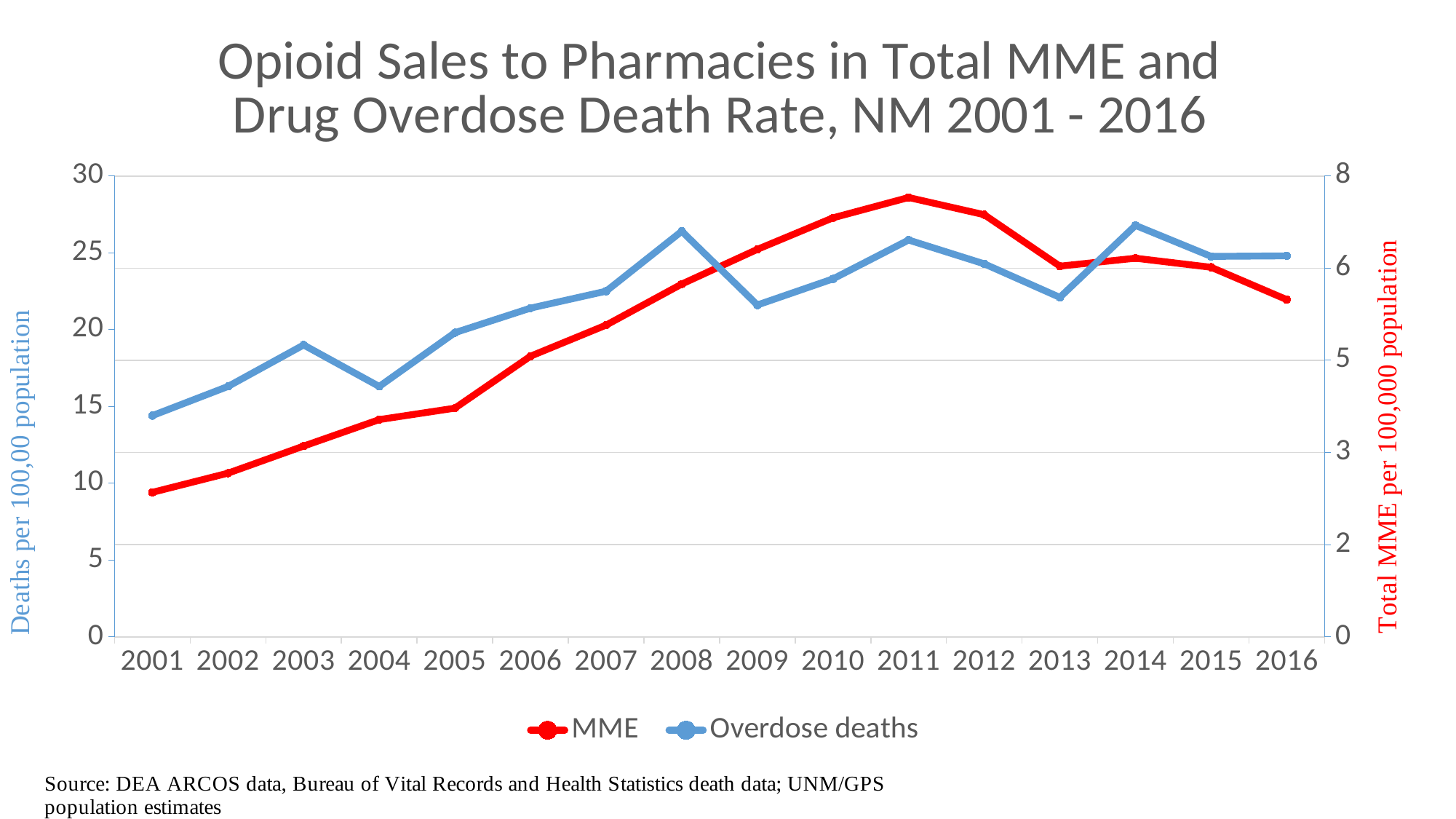
How many series does the legend list? 2 Is the MME value for 2001 greater or less than 3? less What kind of chart is shown on the slide? line chart Which year has the higher Overdose deaths value, 2003 or 2004? 2003 Which colour is used for the Overdose deaths line? blue Is the MME value for 2011 greater or less than 7? greater Is the Overdose deaths value for 2013 greater or less than 25? less How many years are plotted along the x axis? 16 Does the MME series rise or fall from 2001 to 2011? rise In which year is the Overdose deaths series at its lowest value? 2001 In which year does the MME series reach its highest value? 2011 In which year is the MME series at its lowest value? 2001